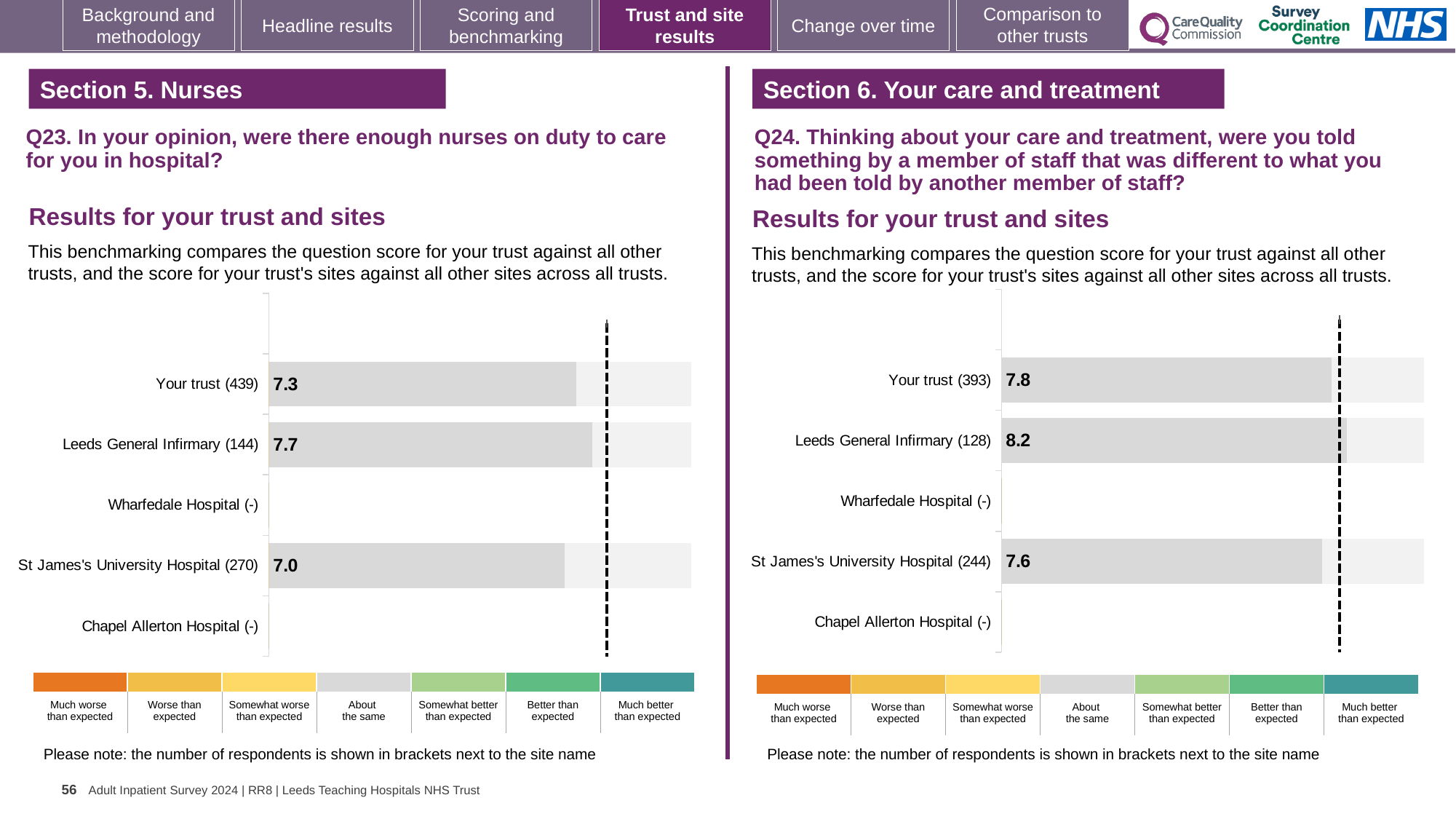
On the Q24 chart (right), what is the score for Your trust? 7.8 On the Q23 chart (left), what is the score for St James's University Hospital? 7.0 On the Q24 chart (right), what is the score for St James's University Hospital? 7.6 On the Q24 chart (right), is the score for Leeds General Infirmary larger or smaller than the score for Your trust? larger What kind of chart is used on the Q24 chart (right)? bar chart On the Q24 chart (right), what is the score for Leeds General Infirmary? 8.2 On the Q23 chart (left), what is the difference between the Leeds General Infirmary score and the St James's University Hospital score? 0.7 On the Q23 chart (left), what is the score for Your trust? 7.3 On the Q23 chart (left), which site or trust has the highest score? Leeds General Infirmary On the Q24 chart (right), which site or trust has the lowest score among those with a value shown? St James's University Hospital On the Q23 chart (left), how many respondents are shown in brackets for Your trust? 439 On the Q23 chart (left), what is the score for Leeds General Infirmary? 7.7